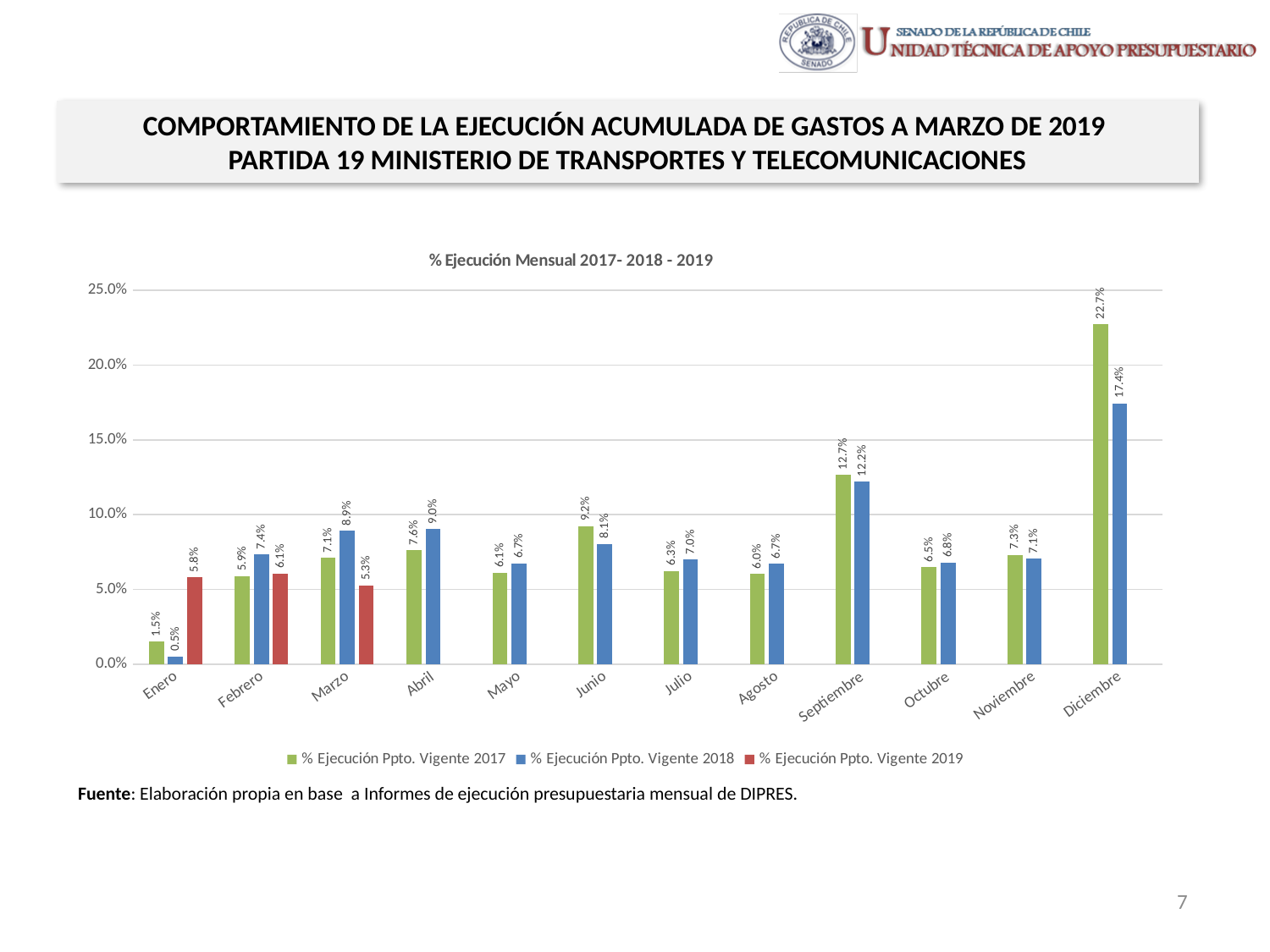
What kind of chart is shown? Bar chart Which month has the lowest value for % Ejecución Ppto. Vigente 2018? Enero What is the value for % Ejecución Ppto. Vigente 2018 in Marzo? 8.9% Which month has the highest value for % Ejecución Ppto. Vigente 2017? Diciembre What is the value for % Ejecución Ppto. Vigente 2019 in Enero? 5.8% What is the difference between the 2017 and 2018 values in Diciembre? 5.3% What is the value for % Ejecución Ppto. Vigente 2017 in Septiembre? 12.7% How many series does the legend list? 3 How many months are shown on the x axis? 12 Is the value for % Ejecución Ppto. Vigente 2017 in Diciembre greater or less than 20.0%? greater Which is larger in Junio: the 2017 value or the 2018 value? 2017 (9.2%) What is the title of the chart? % Ejecución Mensual 2017- 2018 - 2019